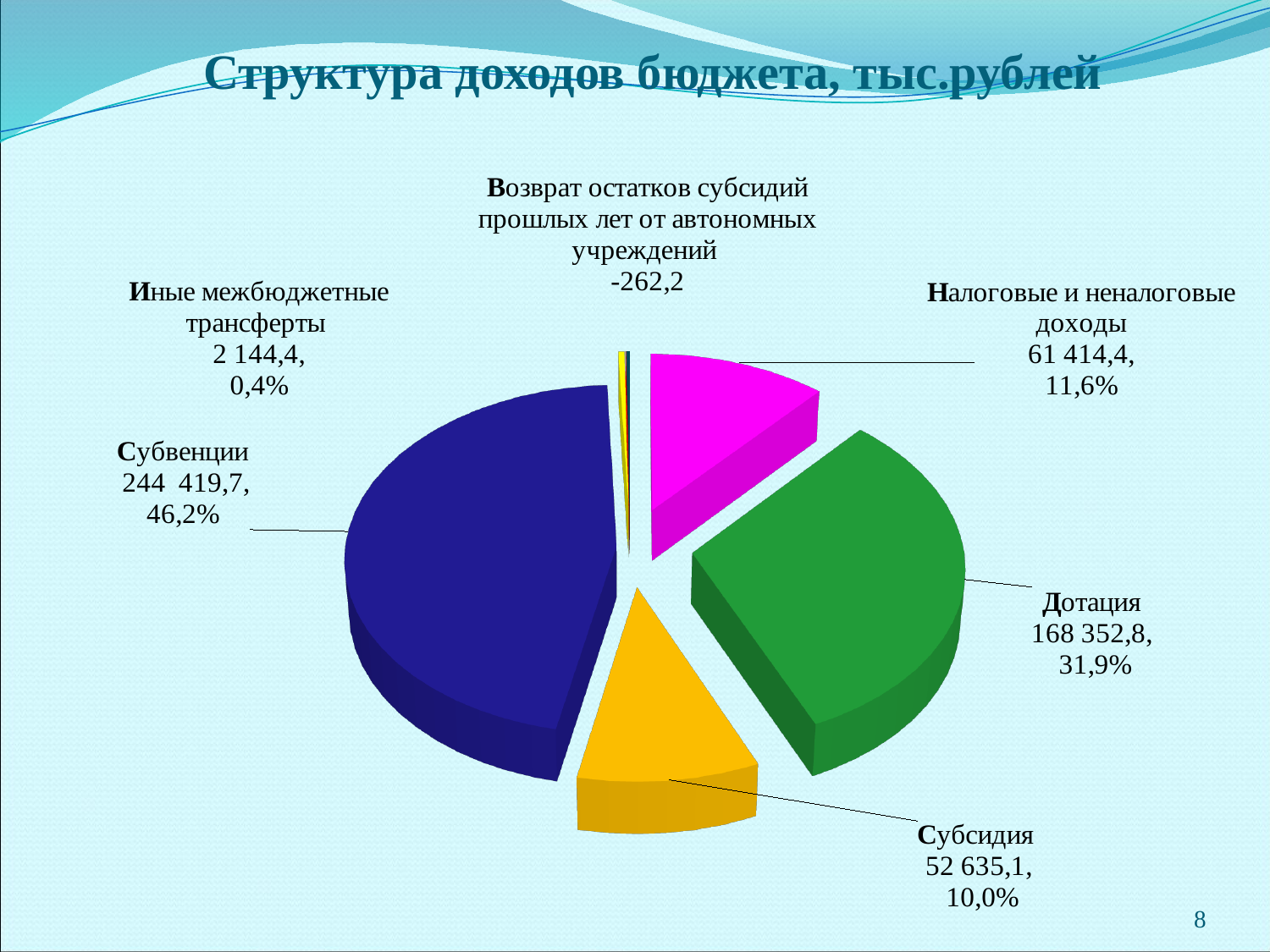
What share of the pie does Дотация represent? 31,9% What kind of chart is shown on the slide? pie chart What is the value for Субвенции? 244 419,7 What is the value for Возврат остатков субсидий прошлых лет от автономных учреждений? -262,2 Which is larger, Дотация or Субсидия? Дотация What percentage is shown for Субсидия? 10,0% What is the difference between the values for Дотация and Субсидия? 115 717,7 What is the value for Налоговые и неналоговые доходы? 61 414,4 Which category has the largest share of the pie? Субвенции What is the title of the chart? Структура доходов бюджета, тыс.рублей What is the value for Иные межбюджетные трансферты? 2 144,4 How many categories are shown in the pie chart? 6